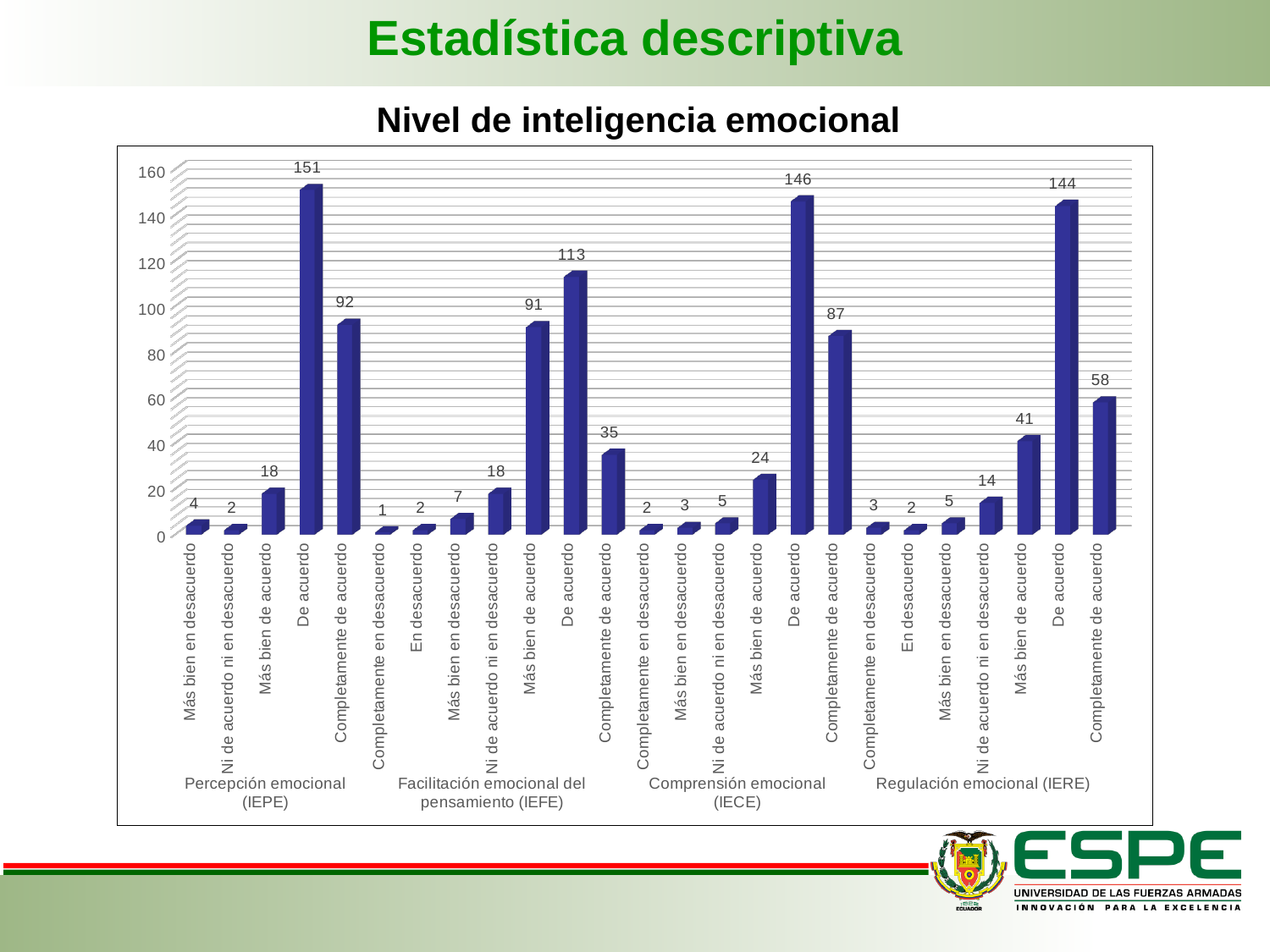
How many bars are plotted in the chart? 25 What is the value for "Ni de acuerdo ni en desacuerdo" in the Facilitación emocional del pensamiento (IEFE) group? 18 What is the title of the chart? Nivel de inteligencia emocional What is the value for "Completamente de acuerdo" in the Comprensión emocional (IECE) group? 87 Which category has the lowest value in the Facilitación emocional del pensamiento (IEFE) group? Completamente en desacuerdo How many groups (dimensions) are shown along the x axis? 4 What kind of chart is shown on the slide? Bar chart Which is larger: "De acuerdo" in Comprensión emocional (IECE) or "De acuerdo" in Facilitación emocional del pensamiento (IEFE)? De acuerdo in Comprensión emocional (IECE) Which bar has the highest value in the whole chart? De acuerdo (Percepción emocional, IEPE) What is the value for "Más bien de acuerdo" in the Regulación emocional (IERE) group? 41 What is the difference between "De acuerdo" and "Completamente de acuerdo" in the Regulación emocional (IERE) group? 86 What is the value for "De acuerdo" in the Percepción emocional (IEPE) group? 151